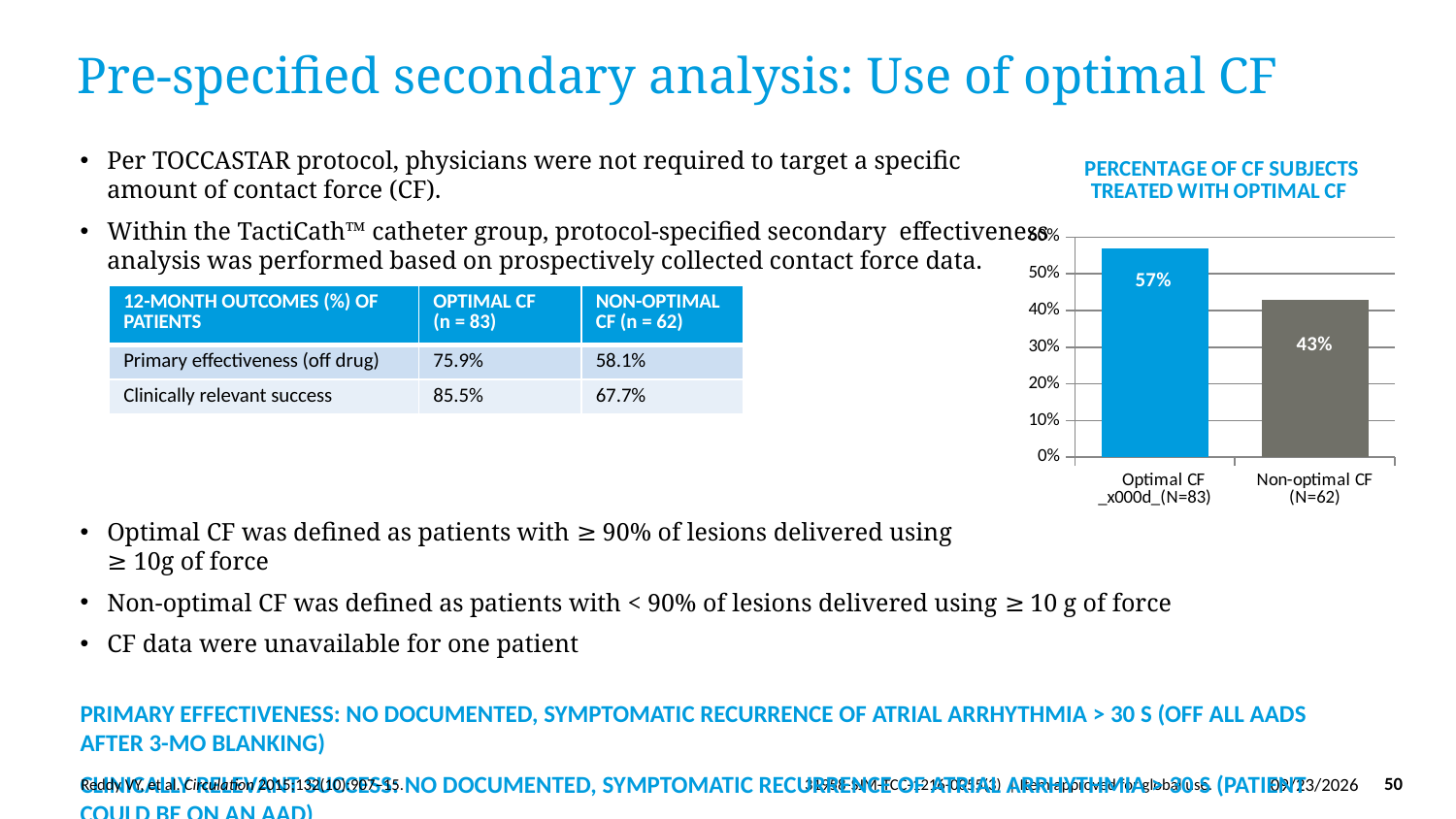
Is the value for Optimal CF greater or less than 50%? greater What is the title of the chart on the slide? PERCENTAGE OF CF SUBJECTS TREATED WITH OPTIMAL CF Which is larger in the chart, the value for Optimal CF or the value for Non-optimal CF? Optimal CF What is the value for Optimal CF (N=83) in the chart? 57% Which category has the lowest value in the chart? Non-optimal CF (N=62) What is the highest value shown on the chart's vertical axis? 60% How many categories are shown in the chart? 2 What kind of chart is shown on the slide? bar chart What is the value for Non-optimal CF (N=62) in the chart? 43% Which category has the highest value in the chart? Optimal CF (N=83) What is the difference between the Optimal CF and Non-optimal CF values in the chart? 14% Is the value for Non-optimal CF greater or less than 50%? less